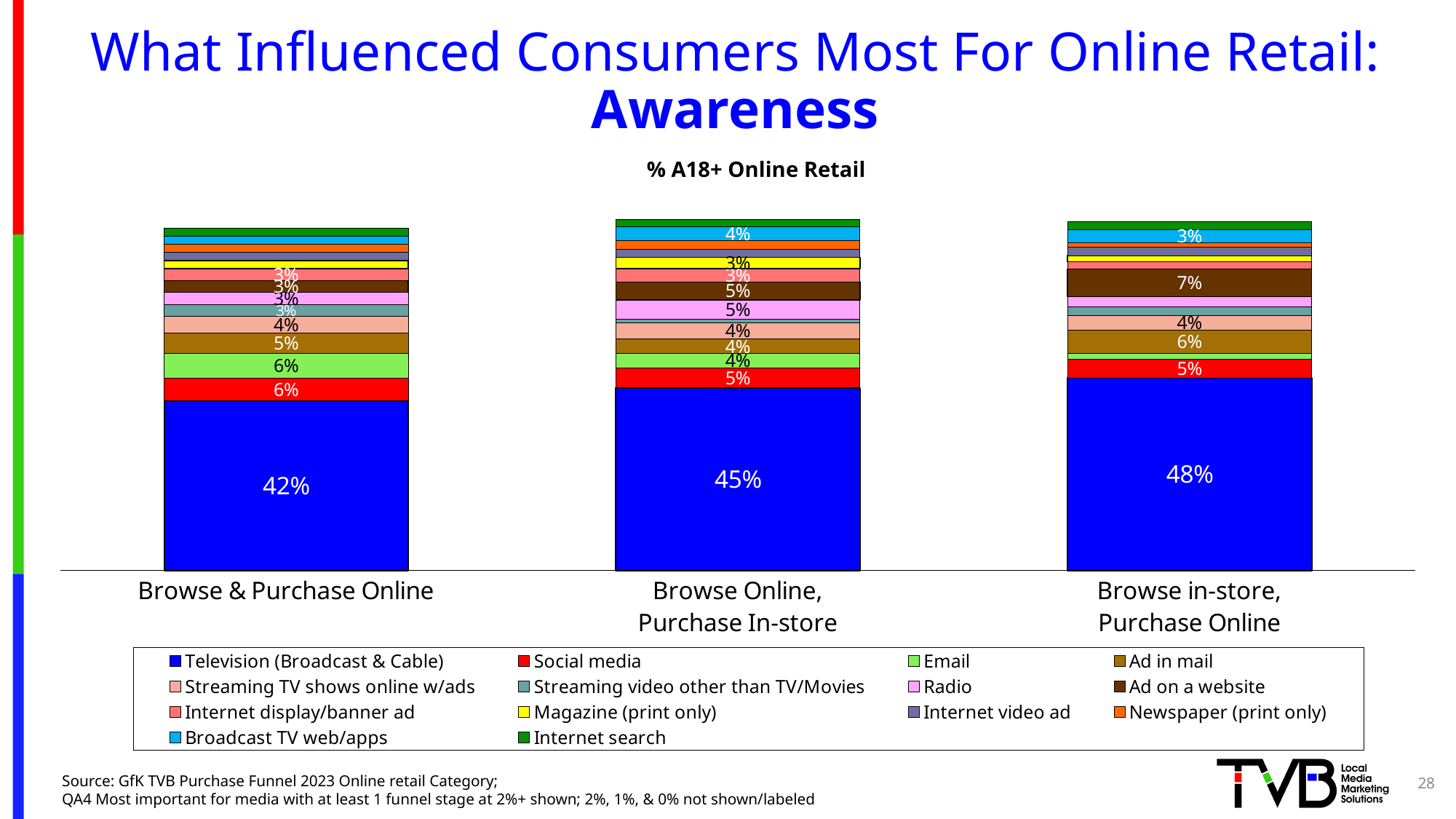
What kind of chart is shown? Stacked bar chart How many series does the legend list? 14 What is the Social media value for Browse & Purchase Online? 6% Which category has the highest Television (Broadcast & Cable) value? Browse in-store, Purchase Online Does the Television (Broadcast & Cable) value rise or fall from left to right across the categories? Rises What is the Television (Broadcast & Cable) value for Browse in-store, Purchase Online? 48% How many categories are shown on the x axis? 3 What is the difference in Television (Broadcast & Cable) between Browse in-store, Purchase Online and Browse & Purchase Online? 6 percentage points What is the Television (Broadcast & Cable) value for Browse & Purchase Online? 42% What is the Ad on a website value for Browse in-store, Purchase Online? 7% What is the Radio value for Browse Online, Purchase In-store? 5% Which category has the larger Ad in mail value: Browse Online, Purchase In-store or Browse in-store, Purchase Online? Browse in-store, Purchase Online